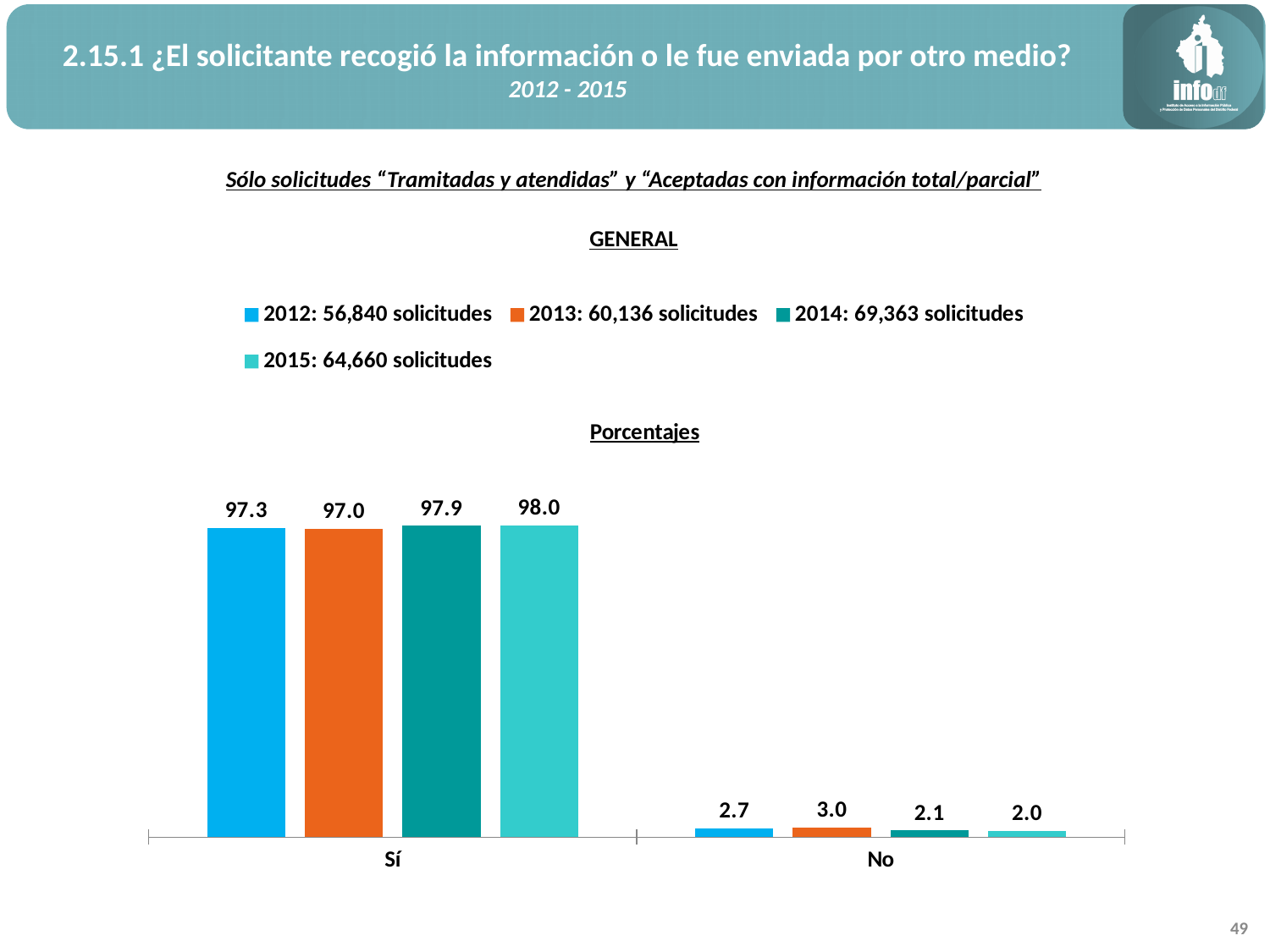
What is the value for 2013 in the "No" category? 3.0 Which year has the highest value in the "No" category? 2013 What is the value for 2015 in the "Sí" category? 98.0 How many series does the legend list? 4 What kind of chart is shown on the slide? bar chart Which year has the lowest value in the "Sí" category? 2013 What is the difference between the 2013 and 2015 values in the "No" category? 1.0 Which is larger: the 2014 value for "No" or the 2012 value for "No"? 2012 How many solicitudes does the legend give for 2014? 69,363 solicitudes What is the value for 2012 in the "Sí" category? 97.3 How many categories are shown on the x axis? 2 What is the difference between the 2015 and 2012 values in the "Sí" category? 0.7